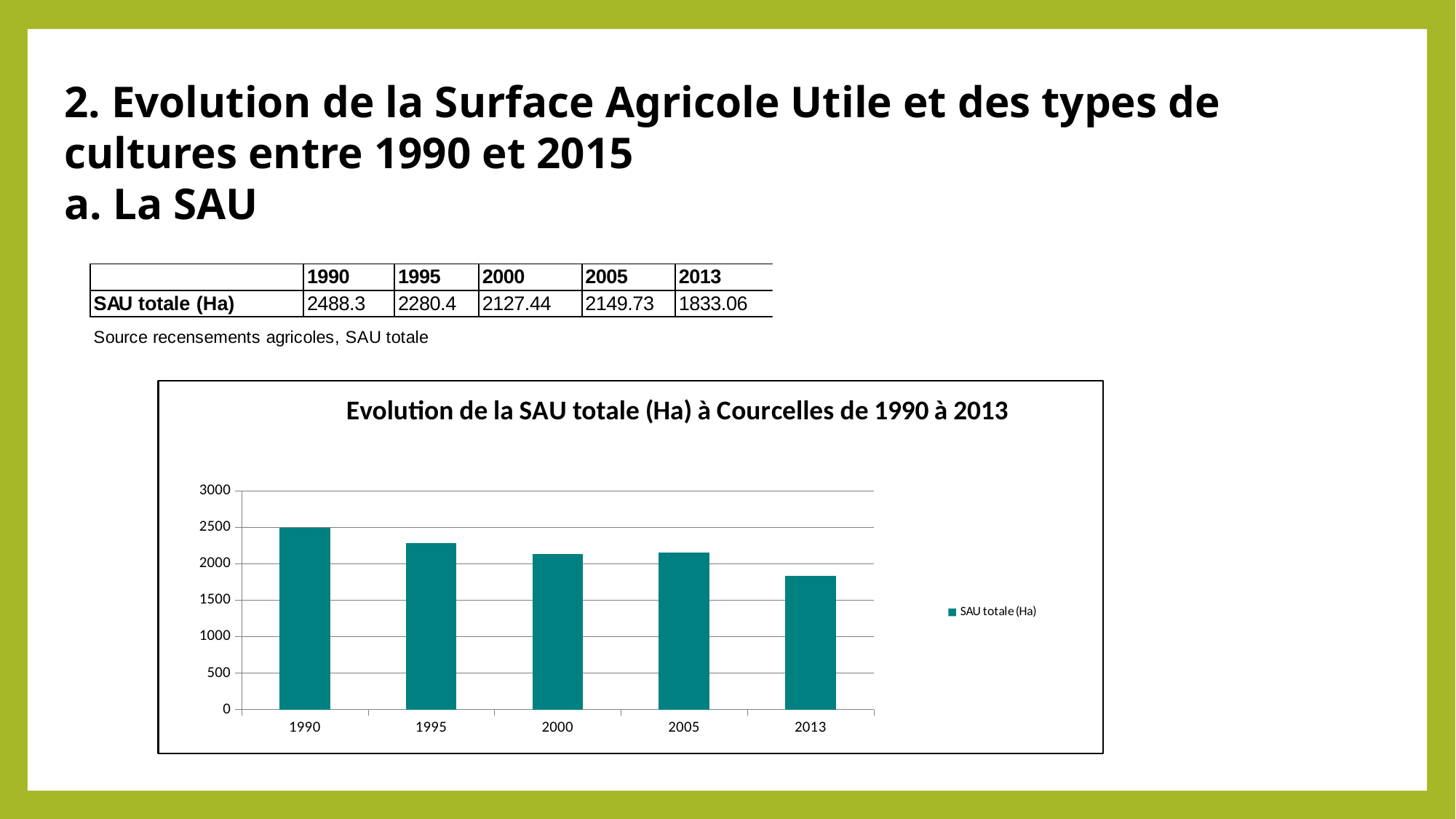
What is the title of the chart? Evolution de la SAU totale (Ha) à Courcelles de 1990 à 2013 Is the SAU totale for 2013 greater or less than 2000? less Overall, do the SAU totale values rise or fall from 1990 to 2013? fall What kind of chart is shown on the slide? bar chart Which is larger, the SAU totale for 1995 or for 2013? 1995 What is the SAU totale (Ha) for 1990? 2488.3 Which year has the lowest SAU totale in the chart? 2013 Which year has the highest SAU totale in the chart? 1990 How many years (categories) are plotted on the x axis of the chart? 5 How many series does the chart legend list? 1 What is the SAU totale (Ha) for 2013? 1833.06 What is the name of the series shown in the chart legend? SAU totale (Ha)